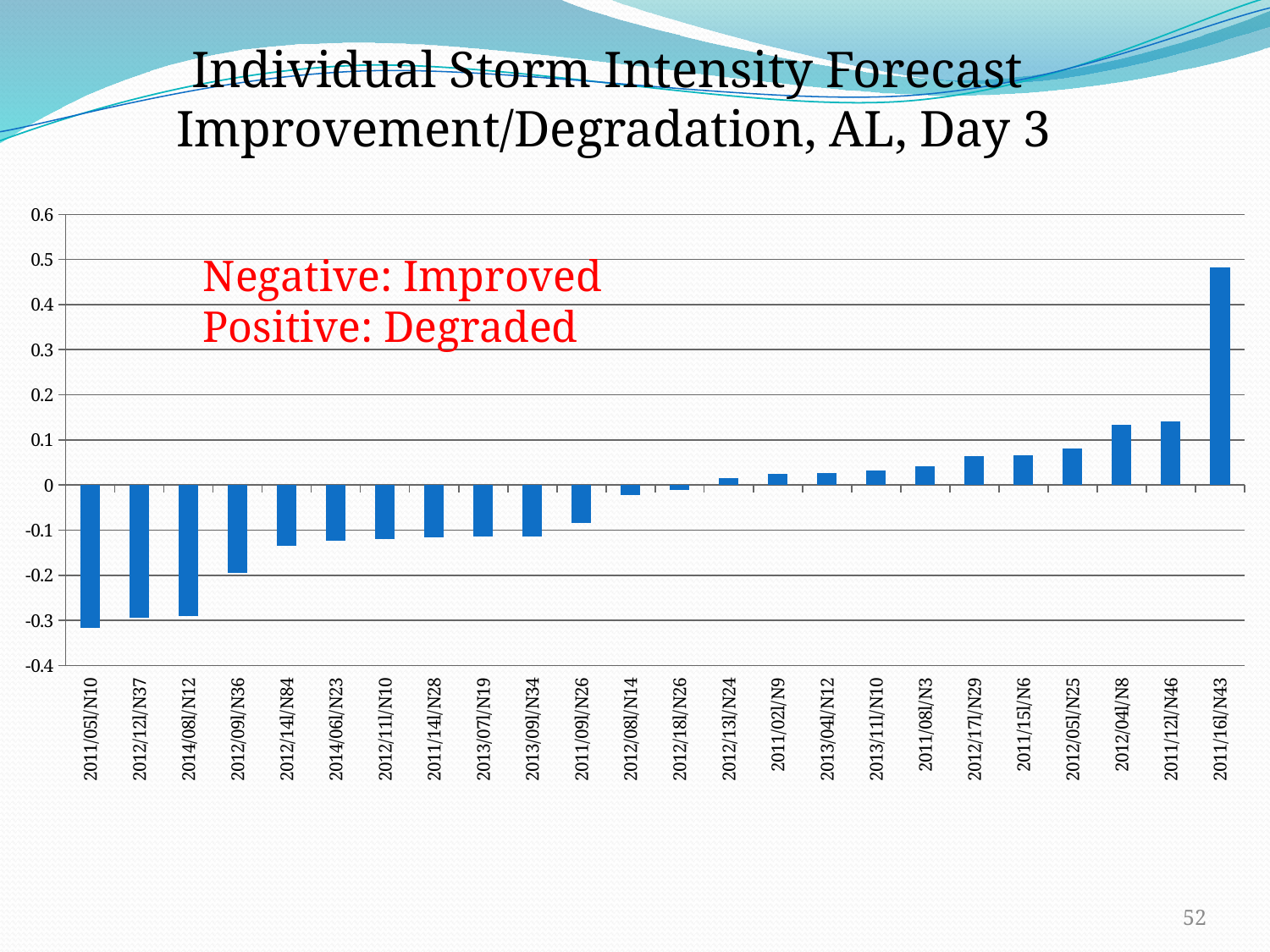
Which storm has the lowest value? 2011/05l/N10 Which has the larger value, 2012/12l/N37 or 2012/14l/N84? 2012/14l/N84 Is the value for 2011/05l/N10 greater or less than -0.3? less Do the values rise or fall moving left to right along the x axis? rise Is the value for 2012/09l/N36 greater or less than -0.1? less According to the red annotation on the chart, what does a negative value indicate? Improved Is the value for 2011/12l/N46 greater or less than 0.1? greater How many storm categories are plotted on the x axis? 24 Which has the larger value, 2011/16l/N43 or 2011/12l/N46? 2011/16l/N43 Which storm has the highest value? 2011/16l/N43 What kind of chart is shown on the slide? bar chart